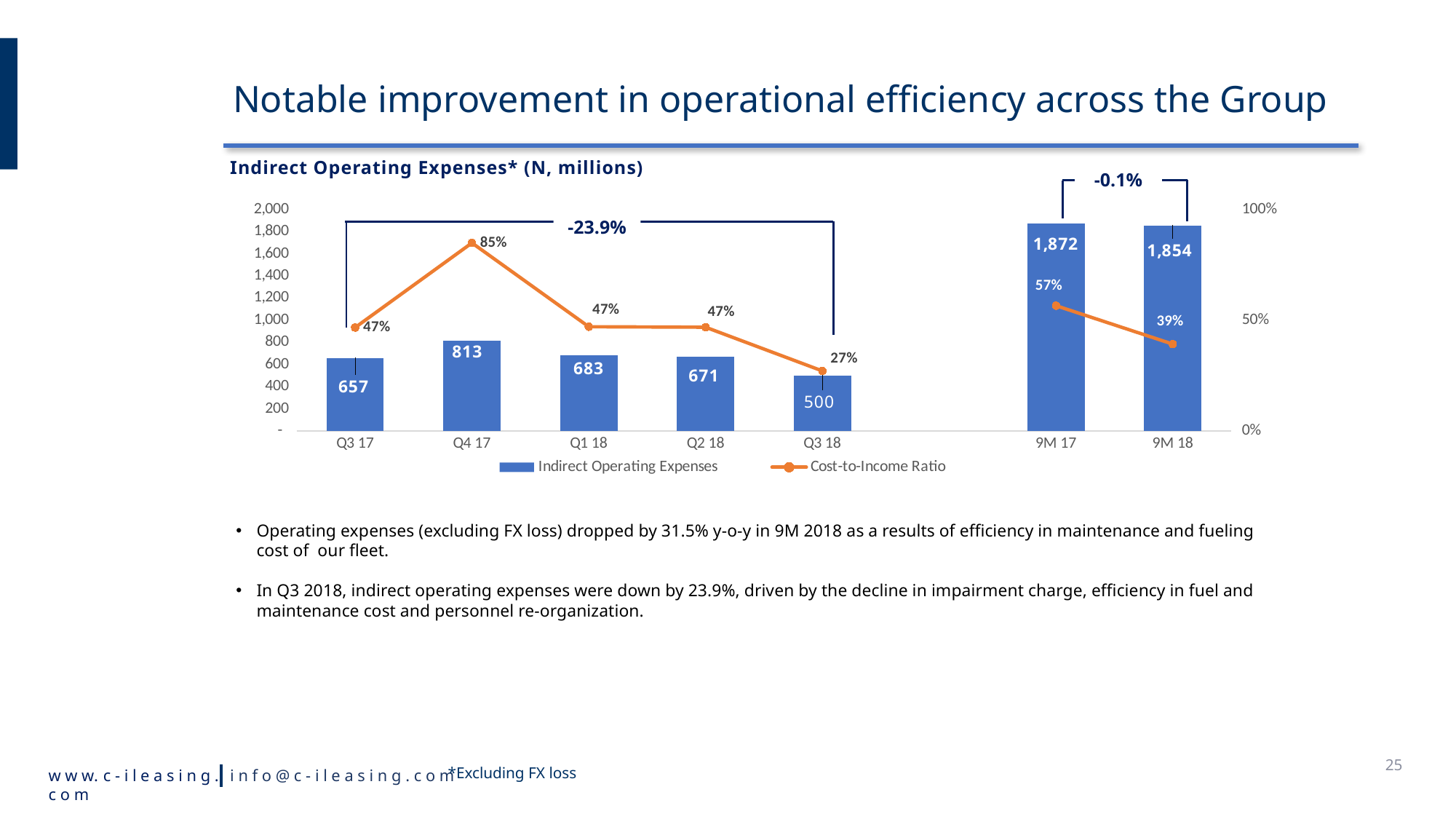
What is the difference in Indirect Operating Expenses between 9M 17 and 9M 18? 18 What is the value of Indirect Operating Expenses for Q4 17? 813 What kind of chart is used to show Indirect Operating Expenses? Bar chart What is the Cost-to-Income Ratio for Q3 18? 27% What is the title of the chart? Indirect Operating Expenses* (N, millions) What is the value of Indirect Operating Expenses for 9M 18? 1,854 What is the Cost-to-Income Ratio for 9M 17? 57% Which quarter has the highest Cost-to-Income Ratio? Q4 17 Which is larger, Indirect Operating Expenses for Q1 18 or Q2 18? Q1 18 How many series does the chart legend list? 2 How many categories are shown on the x axis of the chart? 7 Among the quarterly bars (Q3 17 to Q3 18), which quarter has the lowest Indirect Operating Expenses? Q3 18